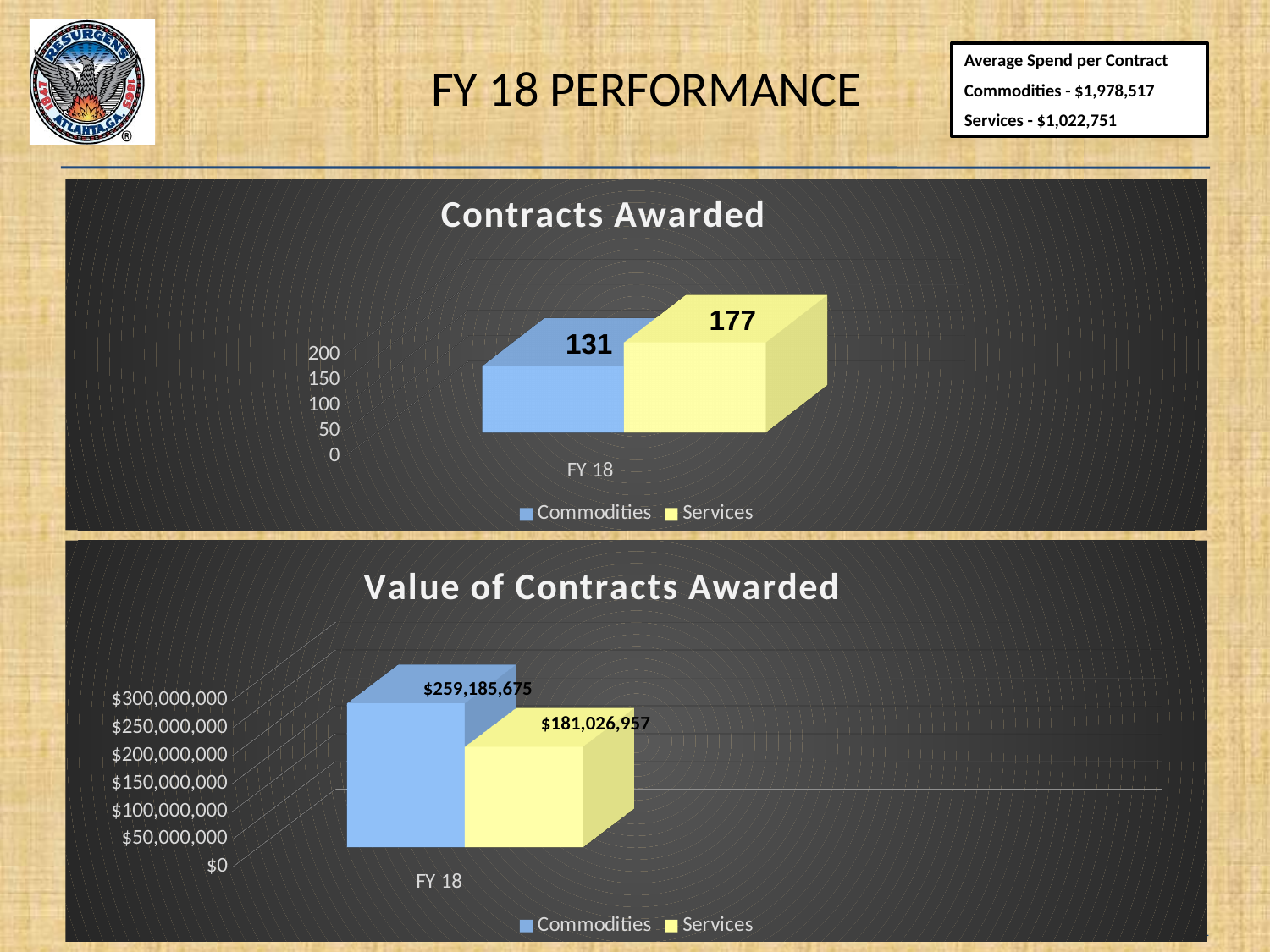
In the 'Contracts Awarded' chart, what is the difference between Services and Commodities? 46 In the 'Value of Contracts Awarded' chart, which series has the lower value? Services In the 'Contracts Awarded' chart, how many series does the legend list? 2 In the 'Contracts Awarded' chart, which series has the higher value? Services In the 'Contracts Awarded' chart, what is the value for Commodities? 131 In the 'Value of Contracts Awarded' chart, what is the value for Commodities? $259,185,675 In the 'Value of Contracts Awarded' chart, what is the value for Services? $181,026,957 In the 'Value of Contracts Awarded' chart, what is the difference between Commodities and Services? $78,158,718 In the 'Value of Contracts Awarded' chart, is the value for Commodities greater or less than $250,000,000? greater In the 'Contracts Awarded' chart, what kind of chart is shown? Bar chart In the 'Contracts Awarded' chart, what is the value for Services? 177 In the 'Value of Contracts Awarded' chart, which colour represents Services in the legend? Yellow